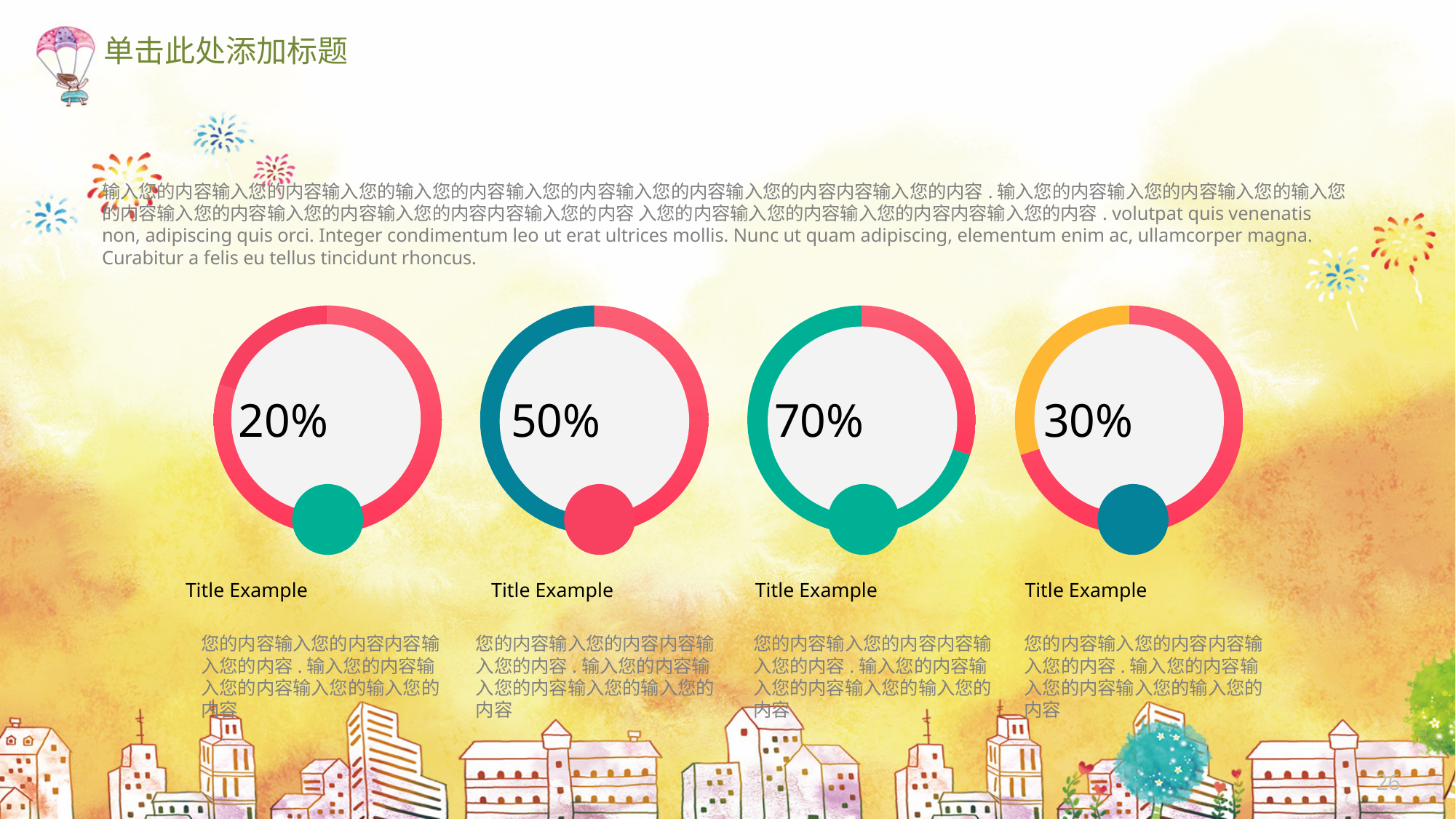
What percentage is shown in the rightmost donut chart? 30% Which is larger: the percentage in the second donut chart or the percentage in the rightmost donut chart? The second donut chart (50%) What percentage is shown in the leftmost donut chart? 20% What percentage is shown in the third donut chart from the left? 70% What is the difference between the percentage in the second donut chart and the percentage in the rightmost donut chart? 20% What is the difference between the percentage in the third donut chart and the percentage in the leftmost donut chart? 50% Which donut chart shows the highest percentage? The third from the left (70%) What colour is the filled portion of the ring in the rightmost donut chart? Orange/yellow How many donut charts are on the slide? 4 What percentage is shown in the second donut chart from the left? 50% What kind of chart is used to display the percentages on the slide? Donut chart Which donut chart shows the lowest percentage? The leftmost (20%)